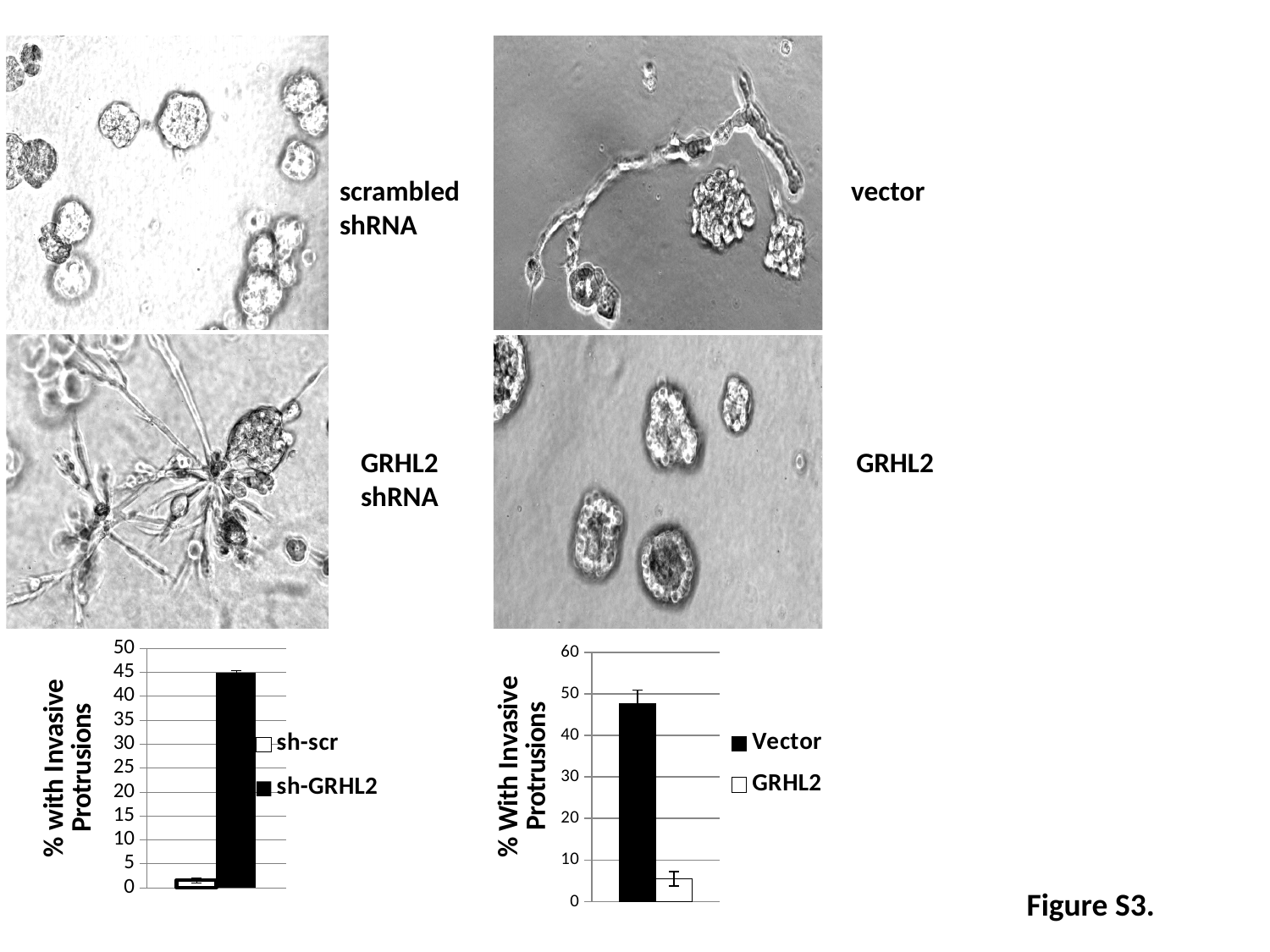
In the left chart, which series has the lowest value? sh-scr What kind of chart is the right chart at the bottom of the slide? bar chart In the right chart, which series has the highest value? Vector What kind of chart is the left chart at the bottom of the slide? bar chart In the left chart, which series has the higher value, sh-scr or sh-GRHL2? sh-GRHL2 In the left chart, is the value for sh-GRHL2 greater or less than 40? greater In the right chart, is the value for GRHL2 greater or less than 10? less In the right chart, is the value for Vector greater or less than 40? greater How many series does the legend of the left chart (% with Invasive Protrusions) list? 2 What is the y-axis label of the right chart? % With Invasive Protrusions How many series does the legend of the right chart (% With Invasive Protrusions) list? 2